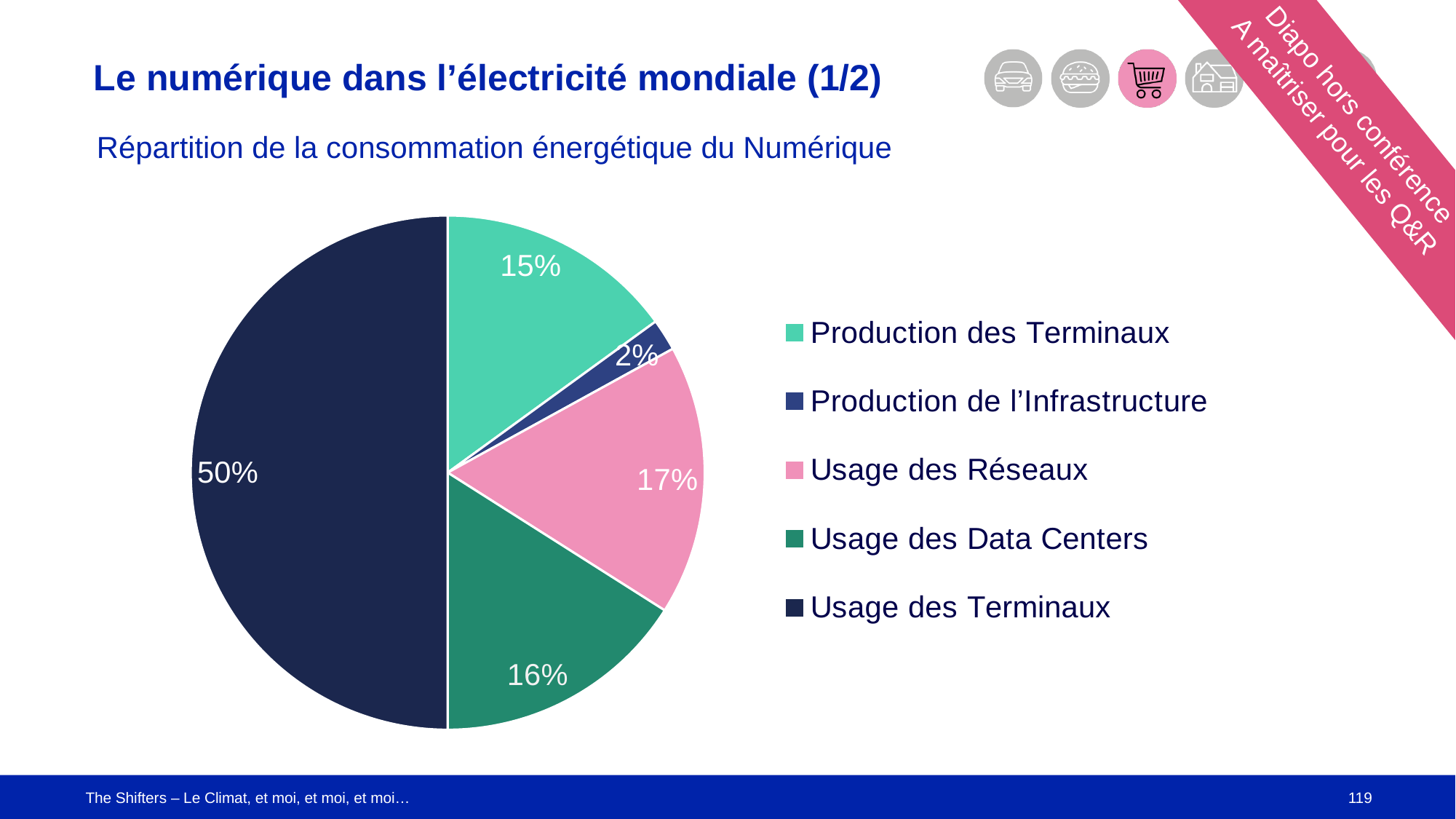
What is the value shown for Usage des Data Centers? 16% What is the value shown for Production des Terminaux? 15% What is the title of the chart? Répartition de la consommation énergétique du Numérique Which category has the smallest slice of the pie? Production de l'Infrastructure What is the value shown for Production de l'Infrastructure? 2% What is the value shown for Usage des Réseaux? 17% Which is larger, the share for Usage des Réseaux or the share for Production des Terminaux? Usage des Réseaux What share of the pie does Usage des Terminaux represent? 50% What kind of chart is shown on the slide? Pie chart What is the difference between the shares of Usage des Terminaux and Usage des Réseaux? 33% How many categories does the pie chart show? 5 Which category has the largest slice of the pie? Usage des Terminaux